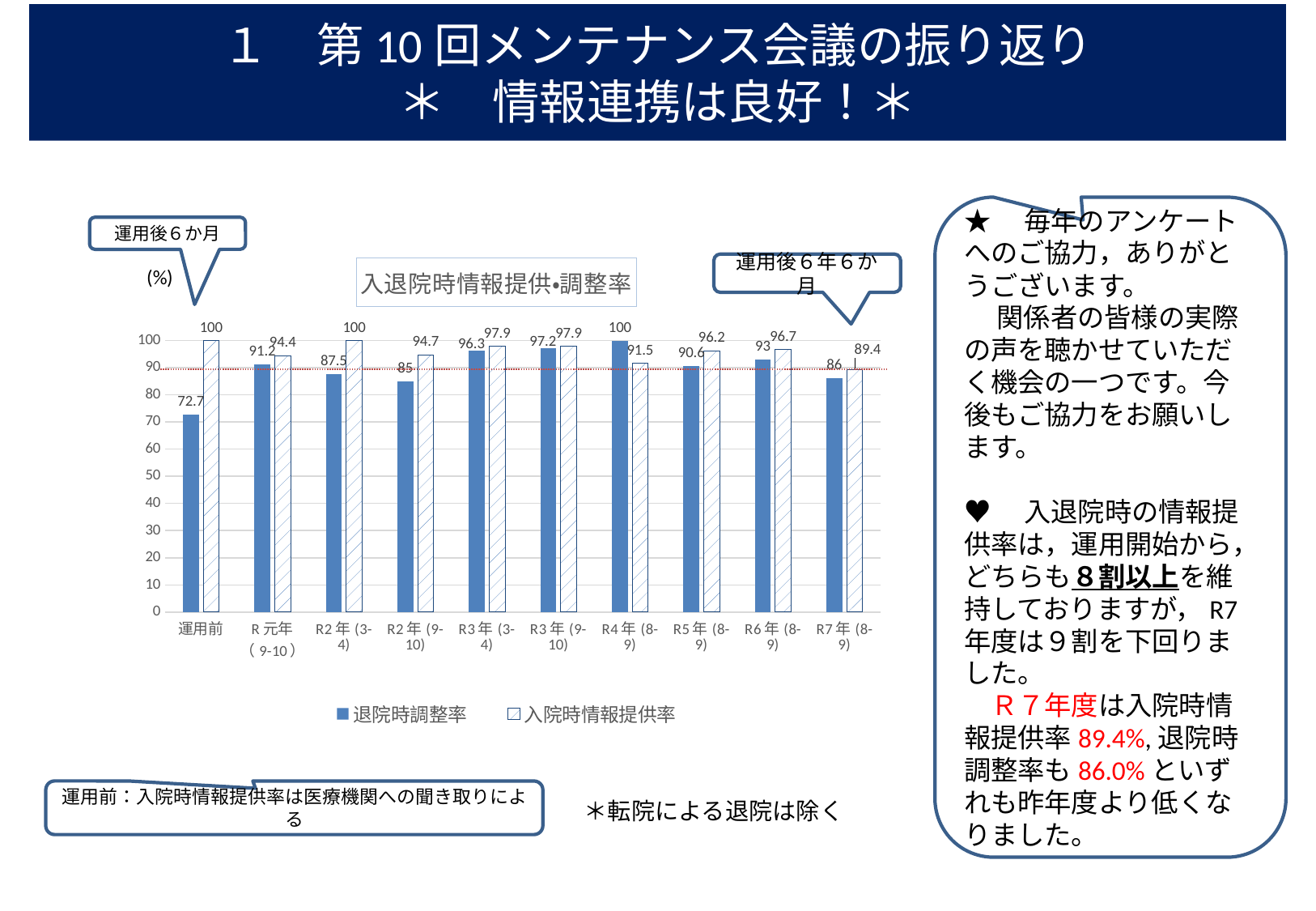
How many categories are shown on the x axis? 10 What is the value of 退院時調整率 for R3年(9-10)? 97.2 For R4年(8-9), which is larger: 退院時調整率 or 入院時情報提供率? 退院時調整率 Is the value of 退院時調整率 for R2年(9-10) greater or less than 90? less How many series does the legend list? 2 What is the value of 入院時情報提供率 for R7年(8-9)? 89.4 What is the title of the chart? 入退院時情報提供•調整率 What kind of chart is shown? bar chart What is the value of 退院時調整率 for 運用前? 72.7 Which category has the lowest value of 入院時情報提供率? R7年(8-9) What is the difference between 入院時情報提供率 and 退院時調整率 for 運用前? 27.3 Which category has the lowest value of 退院時調整率? 運用前